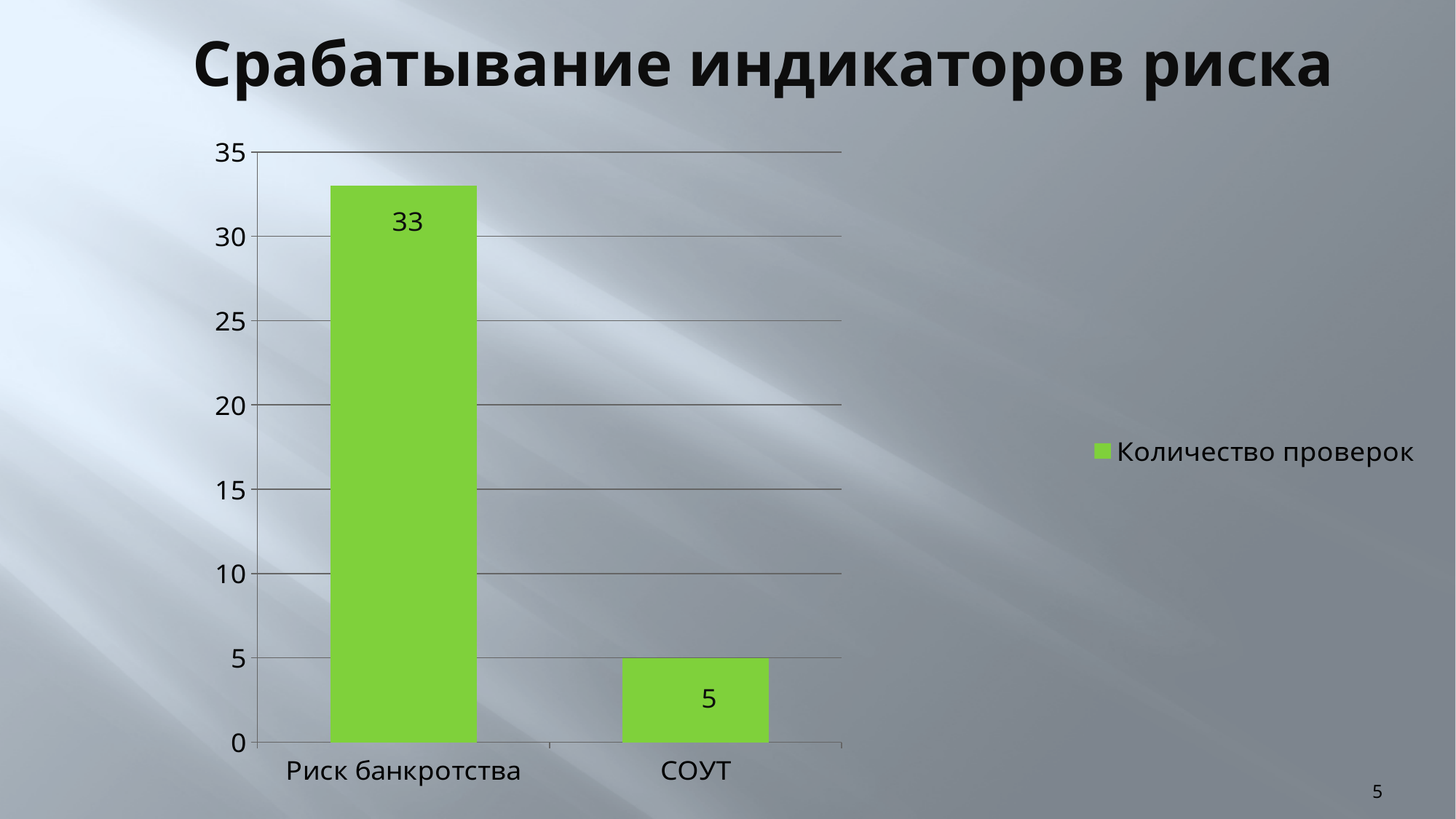
What is the name of the series shown in the legend? Количество проверок Is the value for СОУТ greater or less than 10? less Which is larger, the value for Риск банкротства or the value for СОУТ? Риск банкротства What is the value for Риск банкротства? 33 Is the value for Риск банкротства greater or less than 30? greater What is the difference between the values for Риск банкротства and СОУТ? 28 Which category has the highest value? Риск банкротства What is the value for СОУТ? 5 What kind of chart is shown on the slide? bar chart How many categories are shown on the x axis? 2 How many series does the legend list? 1 Which category has the lowest value? СОУТ